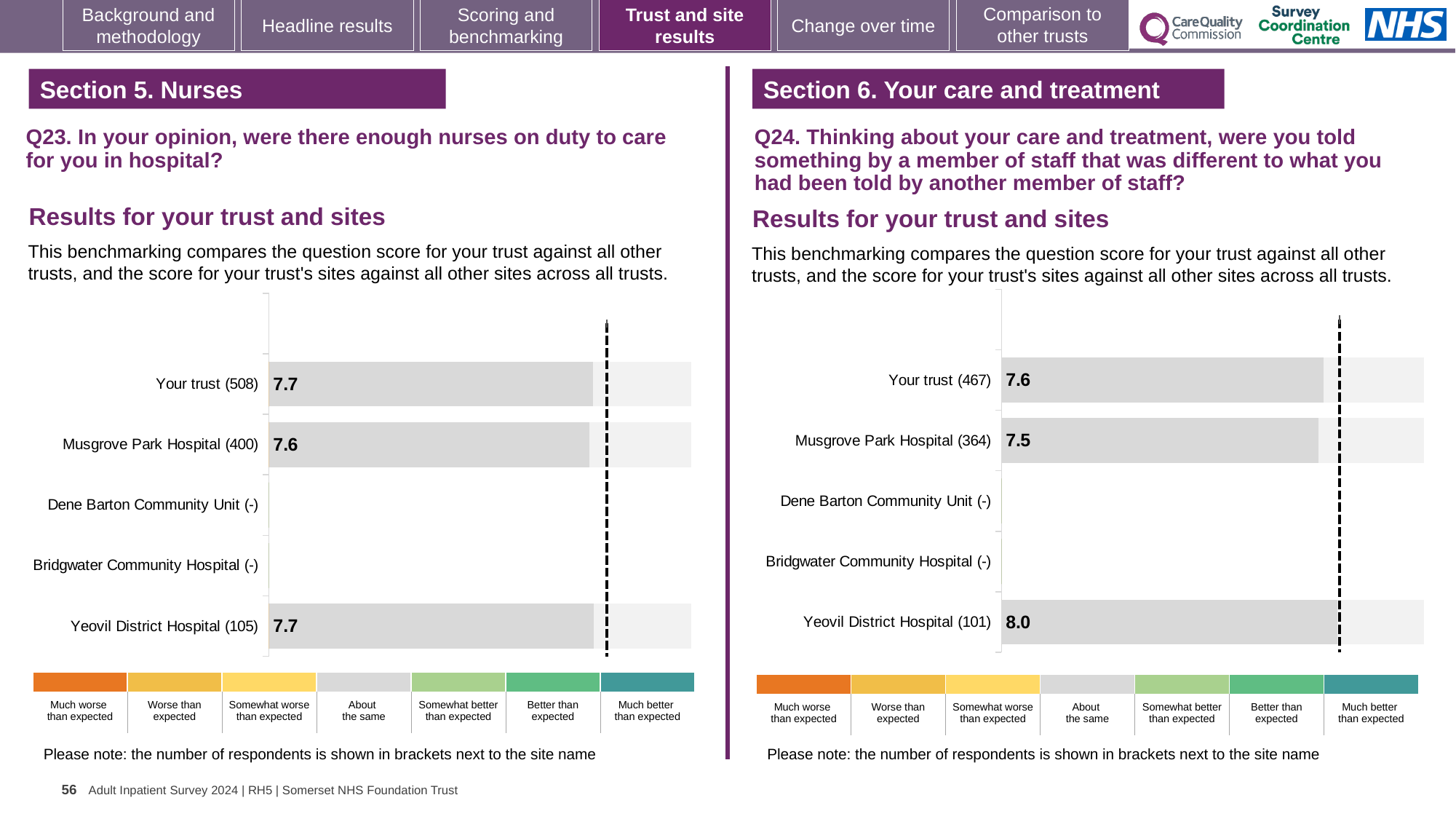
How many site/trust categories are listed on the Q23 chart (left)? 5 On the Q23 chart (left), which is larger: the score for Your trust (508) or Musgrove Park Hospital (400)? Your trust (508) On the Q24 chart (right), which site has the lowest score among those with a plotted value? Musgrove Park Hospital (364) On the Q24 chart (right), which site has the highest score? Yeovil District Hospital (101) On the Q24 chart (right), what is the score for Musgrove Park Hospital (364)? 7.5 On the Q23 chart (left), what is the score for Yeovil District Hospital (105)? 7.7 On the Q23 chart (left), what is the score for Your trust (508)? 7.7 On the Q23 chart (left), what is the score for Musgrove Park Hospital (400)? 7.6 On the Q24 chart (right), what is the score for Yeovil District Hospital (101)? 8.0 On the Q24 chart (right), what is the score for Your trust (467)? 7.6 What kind of chart is used for the Q24 results (right)? Bar chart On the Q24 chart (right), what is the difference between the scores for Yeovil District Hospital (101) and Musgrove Park Hospital (364)? 0.5